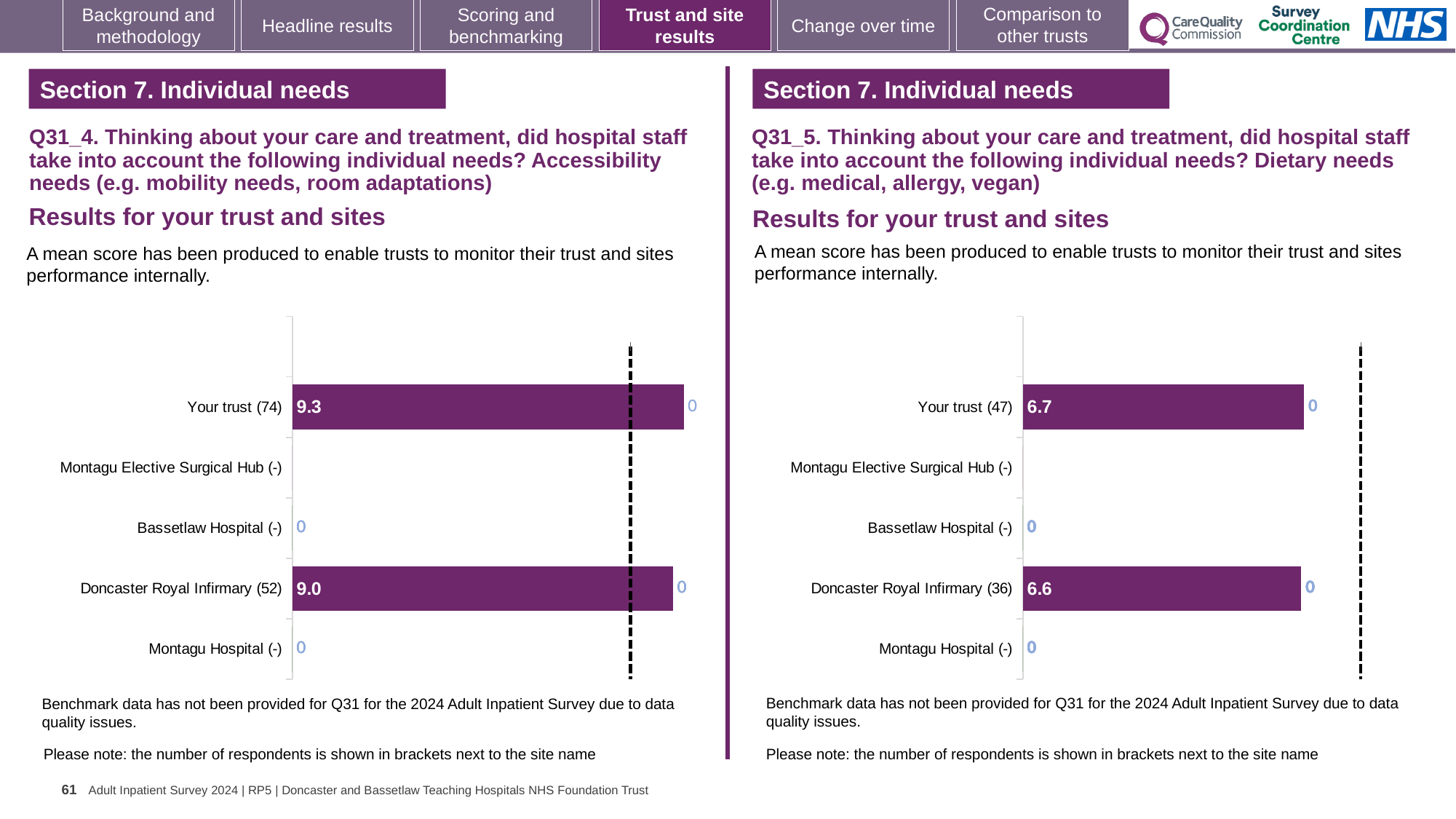
In the right chart (Q31_5, dietary needs), what is the mean score for Doncaster Royal Infirmary? 6.6 In the left chart (Q31_4, accessibility needs), what is the mean score for Your trust? 9.3 What kind of chart is used in the right chart (Q31_5, dietary needs)? Bar chart In the left chart (Q31_4, accessibility needs), what is the difference between the mean score for Your trust and for Doncaster Royal Infirmary? 0.3 How many respondents are shown in brackets for Your trust in the right chart (Q31_5, dietary needs)? 47 In the left chart (Q31_4, accessibility needs), what is the mean score for Doncaster Royal Infirmary? 9.0 In the right chart (Q31_5, dietary needs), what is the difference between the mean score for Your trust and for Doncaster Royal Infirmary? 0.1 How many site categories are listed on the y axis of the left chart (Q31_4, accessibility needs)? 5 In the left chart (Q31_4, accessibility needs), which has the higher mean score: Your trust or Doncaster Royal Infirmary? Your trust Which question does the right chart relate to? Q31_5 In the right chart (Q31_5, dietary needs), what is the mean score for Your trust? 6.7 How many respondents are shown in brackets for Doncaster Royal Infirmary in the left chart (Q31_4, accessibility needs)? 52